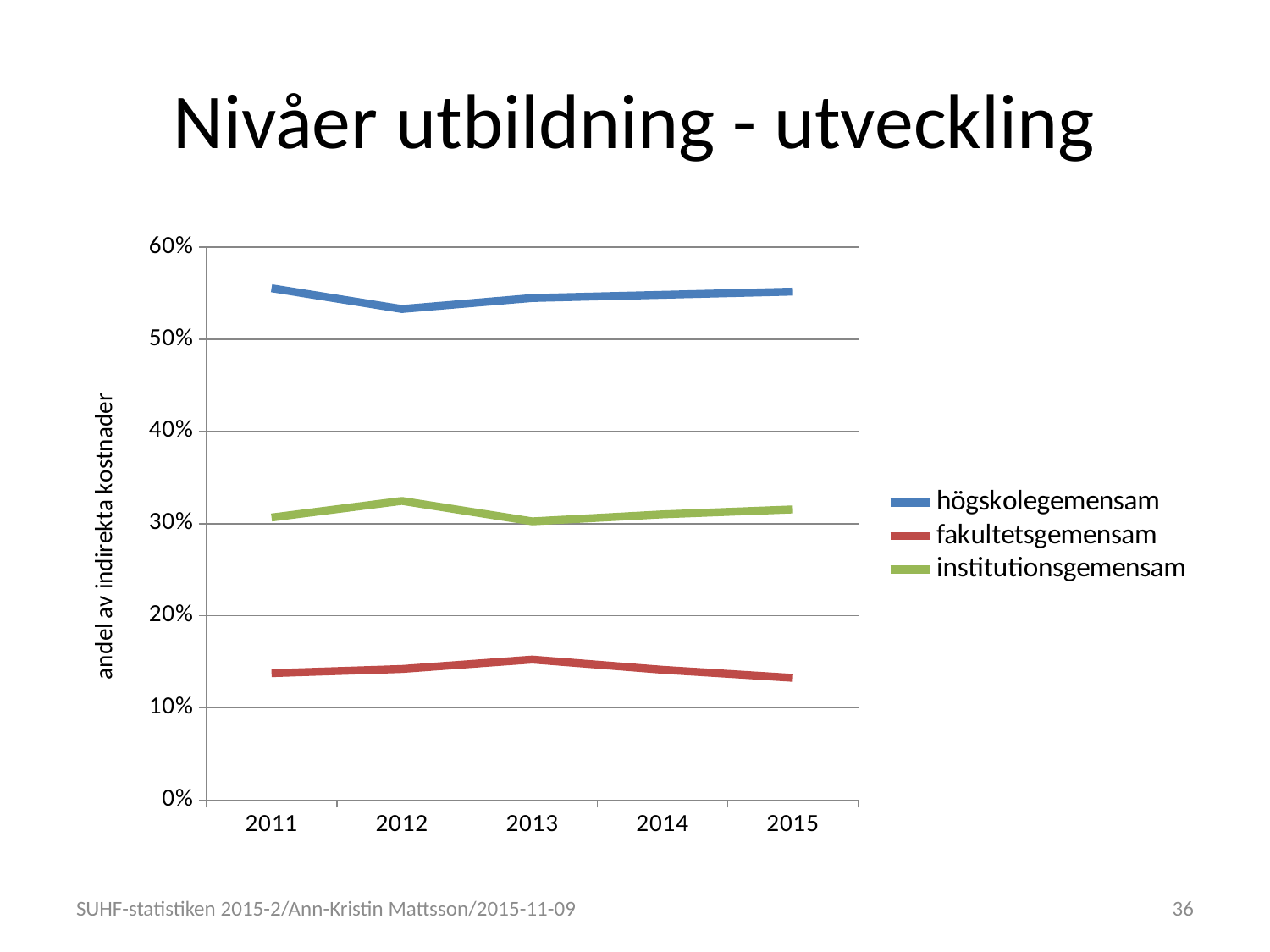
Which series has the lowest value in 2011? fakultetsgemensam What is the label on the vertical axis? andel av indirekta kostnader Which series has the highest value in 2015? högskolegemensam Does the value for fakultetsgemensam rise or fall from 2013 to 2015? fall In which year is the value for fakultetsgemensam highest? 2013 Is the value for fakultetsgemensam in 2015 greater or less than 20%? less How many years are shown on the x axis? 5 In which year is the value for institutionsgemensam highest? 2012 What kind of chart is shown on the slide? line chart In which year is the value for högskolegemensam lowest? 2012 How many series does the legend list? 3 Is the value for högskolegemensam in 2012 greater or less than 50%? greater